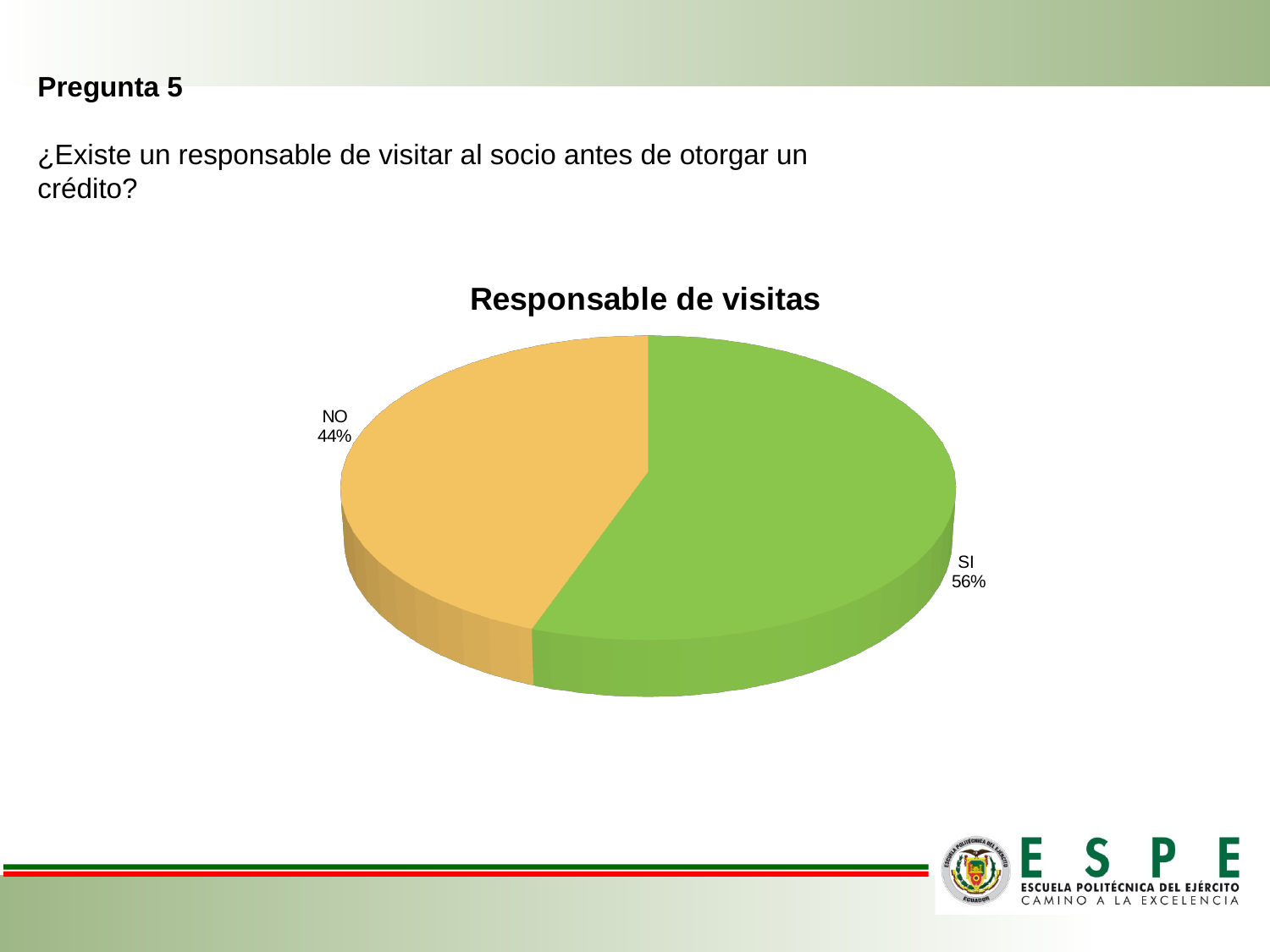
What percentage of the pie is labelled NO? 44% Which slice is larger, SI or NO? SI What is the title of the chart? Responsable de visitas How many slices does the pie chart have? 2 What is the difference in percentage points between the SI and NO slices? 12 Which slice is the smallest in the pie chart? NO What percentage of the pie is labelled SI? 56% Which slice is the largest in the pie chart? SI What type of chart is shown on the slide? pie chart What colour is the SI slice? green What share of the pie does the NO slice represent? 44%